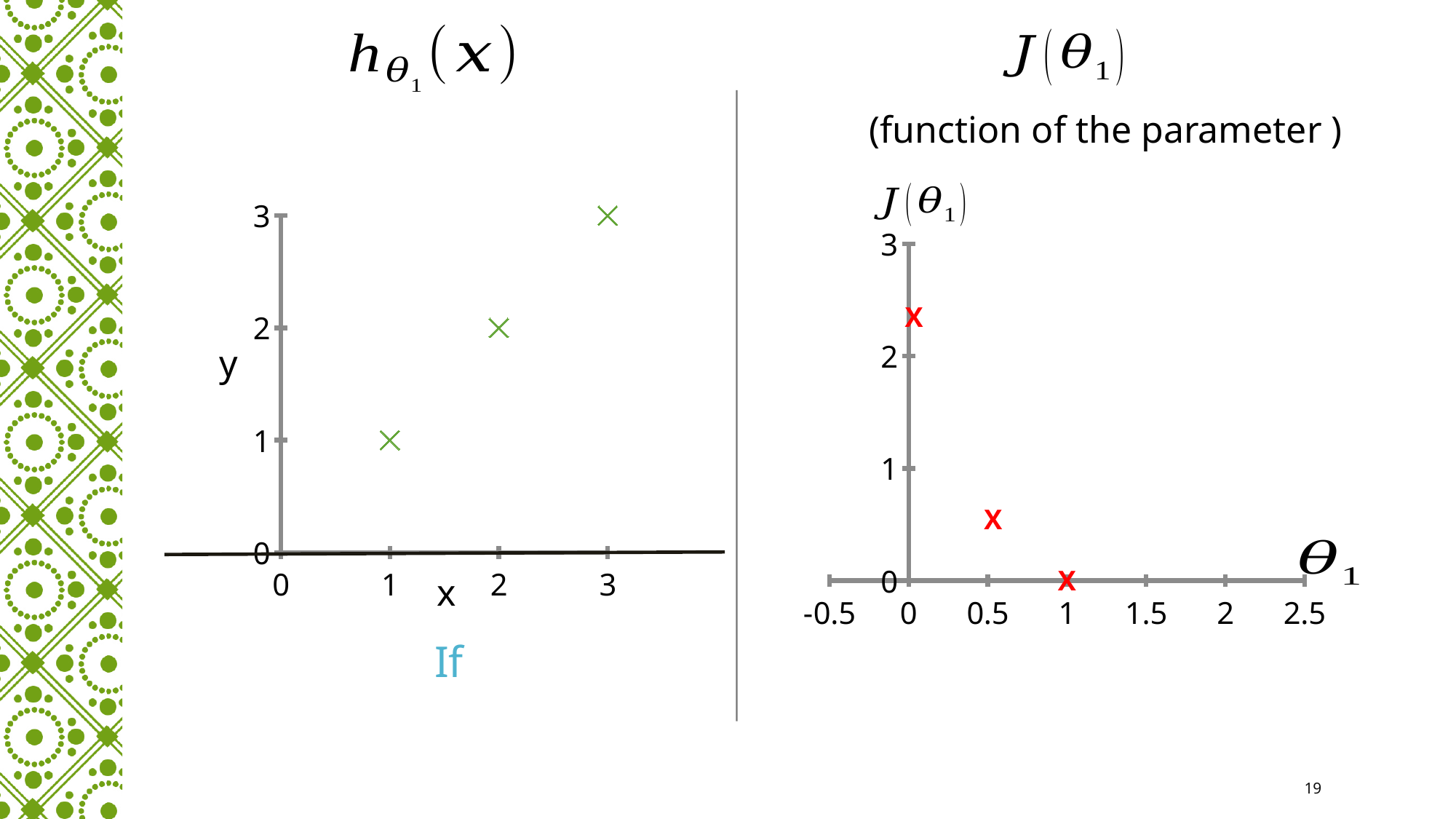
On the left chart, which x value has the highest y value? 3 On the right chart, is the value at θ1 = 0 greater or less than 2? greater On the left chart, what is the y value of the point at x = 1? 1 On the left chart, what is the y value of the point at x = 2? 2 On the left chart, what is the y value of the point at x = 3? 3 On the right chart, which θ1 value has the lowest J(θ1)? 1 On the right chart, do the values rise or fall as θ1 increases from 0 to 1? fall On the left chart, how many data points are plotted? 3 On the right chart, what is the value of J(θ1) at θ1 = 1? 0 On the right chart, how many data points are plotted? 3 On the right chart, is the value at θ1 = 0.5 greater or less than 1? less On the left chart, do the y values rise or fall as x increases? rise